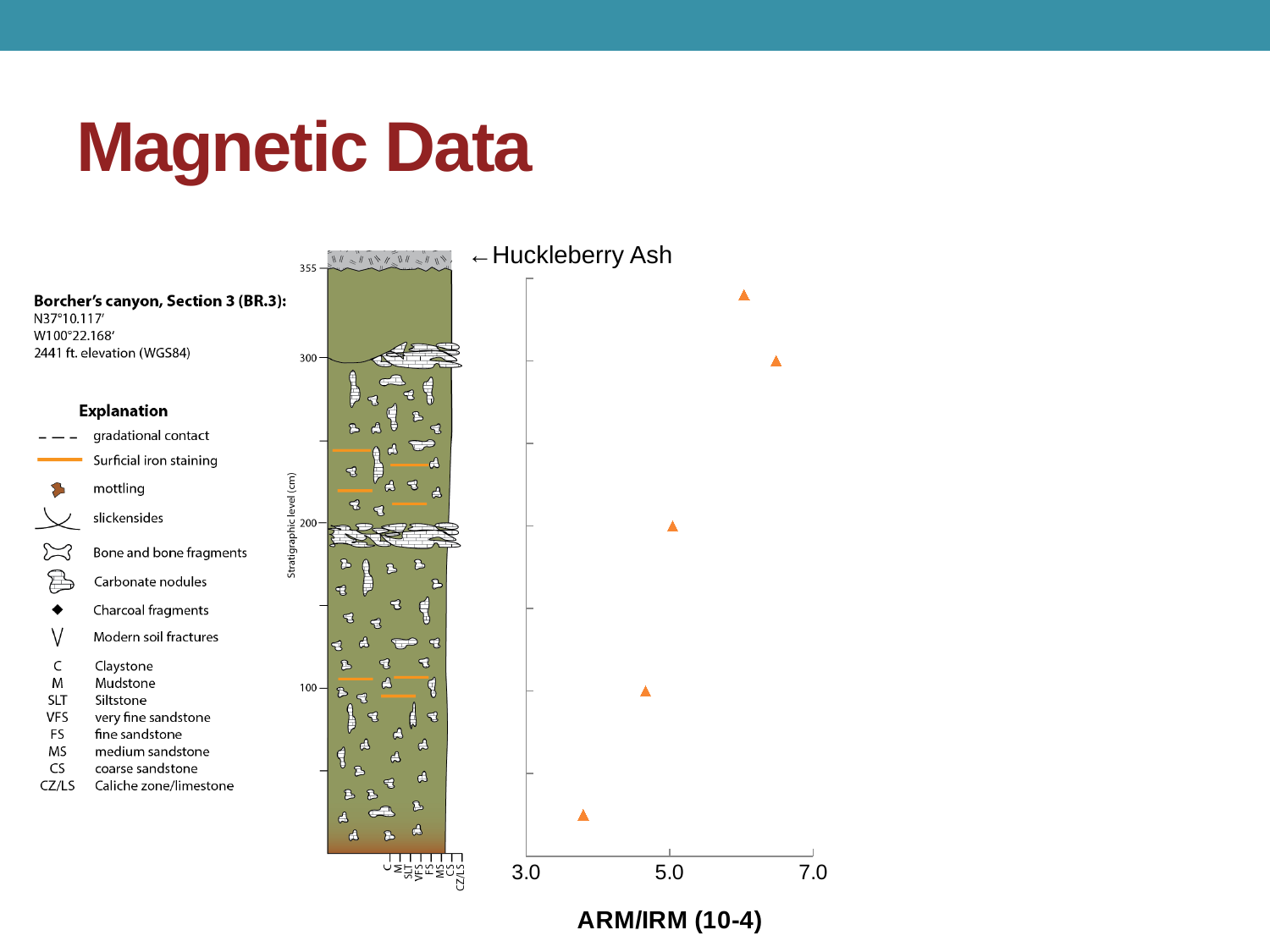
As stratigraphic level increases up the section, do the ARM/IRM values generally rise or fall? rise What kind of chart is the plot on the right of the slide? scatter chart Which plotted point has the highest ARM/IRM value: the one at the 300 cm level or the one at the 100 cm level? the one at the 300 cm level Is the ARM/IRM value of the point at the 300 cm stratigraphic level greater or less than 5.0? greater Is the ARM/IRM value of the point at the 300 cm stratigraphic level greater or less than 7.0? less What is the label of the x axis of the chart on the right? ARM/IRM (10-4) Is the ARM/IRM value of the lowest plotted point (near the base of the section) greater or less than 5.0? less What colour are the markers in the ARM/IRM chart? orange How many data points (triangles) are plotted in the ARM/IRM chart? 5 Which plotted point has the lowest ARM/IRM value? the lowest point, near the base of the section